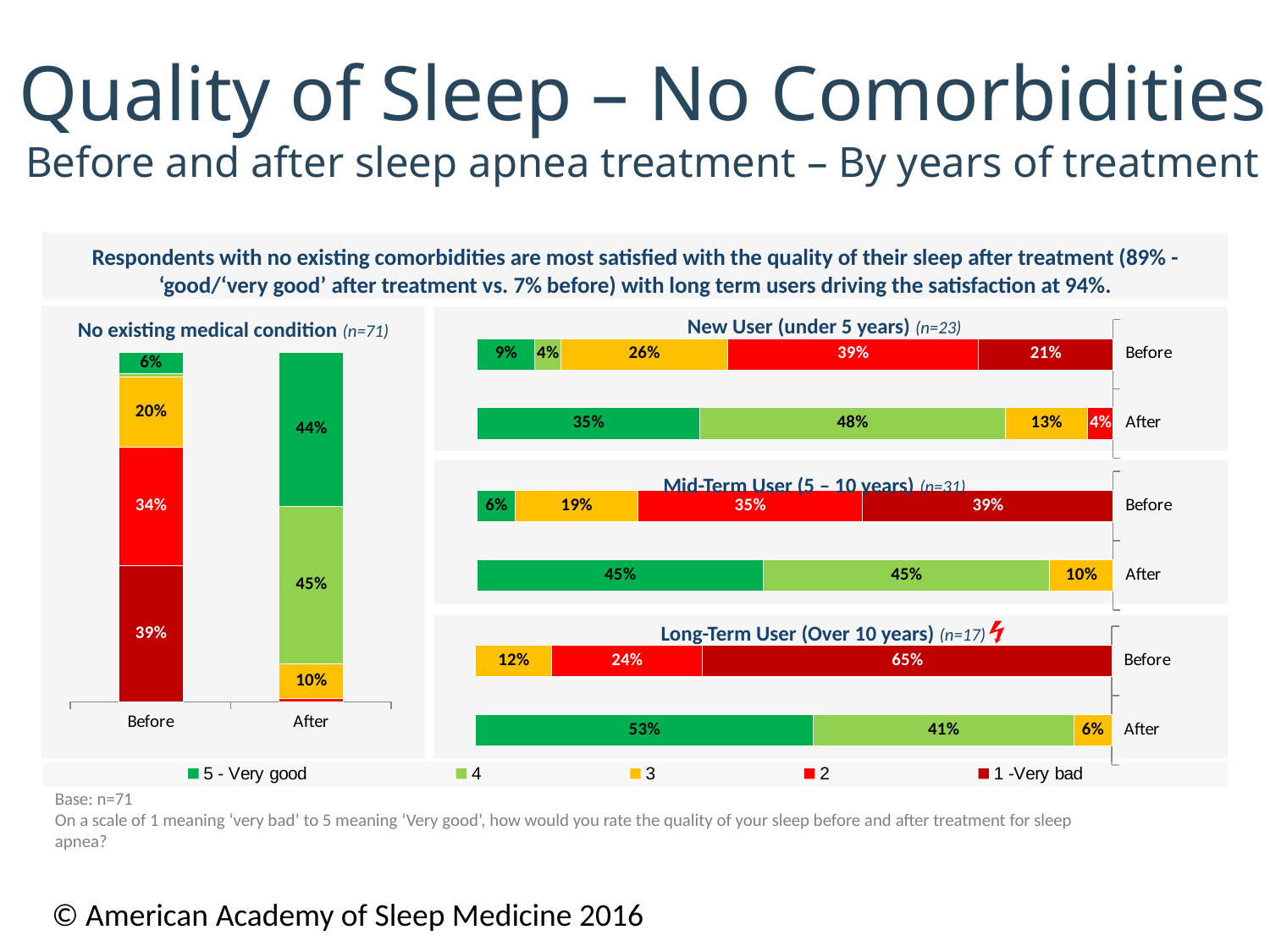
In the 'No existing medical condition' chart, what percentage of the After bar is '5 - Very good'? 44% What type of chart is the 'New User (under 5 years)' chart? Stacked bar chart In the 'Long-Term User (Over 10 years)' chart, what is the value of the '5 - Very good' segment in the After bar? 53% How many series does the shared legend at the bottom of the slide list? 5 In the 'New User (under 5 years)' chart, what is the value of the '2' segment in the Before bar? 39% In the 'Long-Term User (Over 10 years)' chart, what is the value of the '1 - Very bad' segment in the Before bar? 65% In the 'New User (under 5 years)' chart, what is the value of the '4' segment in the After bar? 48% In the 'No existing medical condition' chart, what percentage of the Before bar is '1 - Very bad'? 39% How much larger is the '5 - Very good' After value in the 'Long-Term User' chart than in the 'New User' chart? 18 percentage points In the 'Long-Term User (Over 10 years)' chart, which rating has the largest segment in the Before bar? 1 - Very bad In the 'Mid-Term User (5 – 10 years)' chart, which segment of the Before bar is larger: '2' or '1 - Very bad'? 1 - Very bad In the 'Mid-Term User (5 – 10 years)' chart, what is the value of the '3' segment in the After bar? 10%